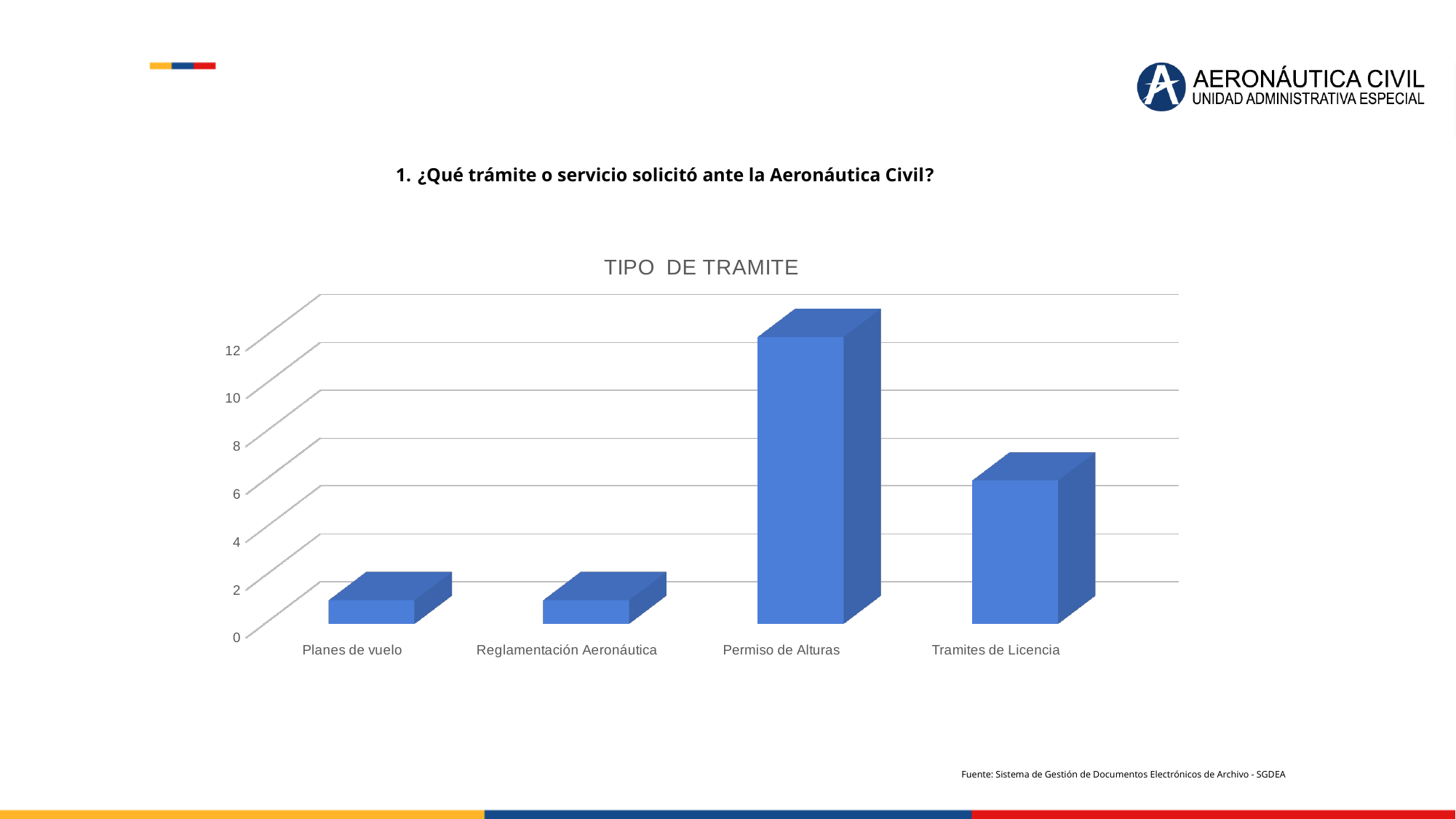
What is the highest value labelled on the vertical axis of the chart? 12 Is the value for Planes de vuelo greater or less than 2? less Is the value for Permiso de Alturas greater or less than 10? greater How many categories are shown on the x axis of the chart? 4 Which category has the highest value in the chart? Permiso de Alturas What is the title of the chart? TIPO DE TRAMITE Which is larger, the value for Tramites de Licencia or the value for Planes de vuelo? Tramites de Licencia Is the value for Tramites de Licencia greater or less than 4? greater Which is larger, the value for Permiso de Alturas or the value for Tramites de Licencia? Permiso de Alturas What type of chart is shown on the slide? bar chart